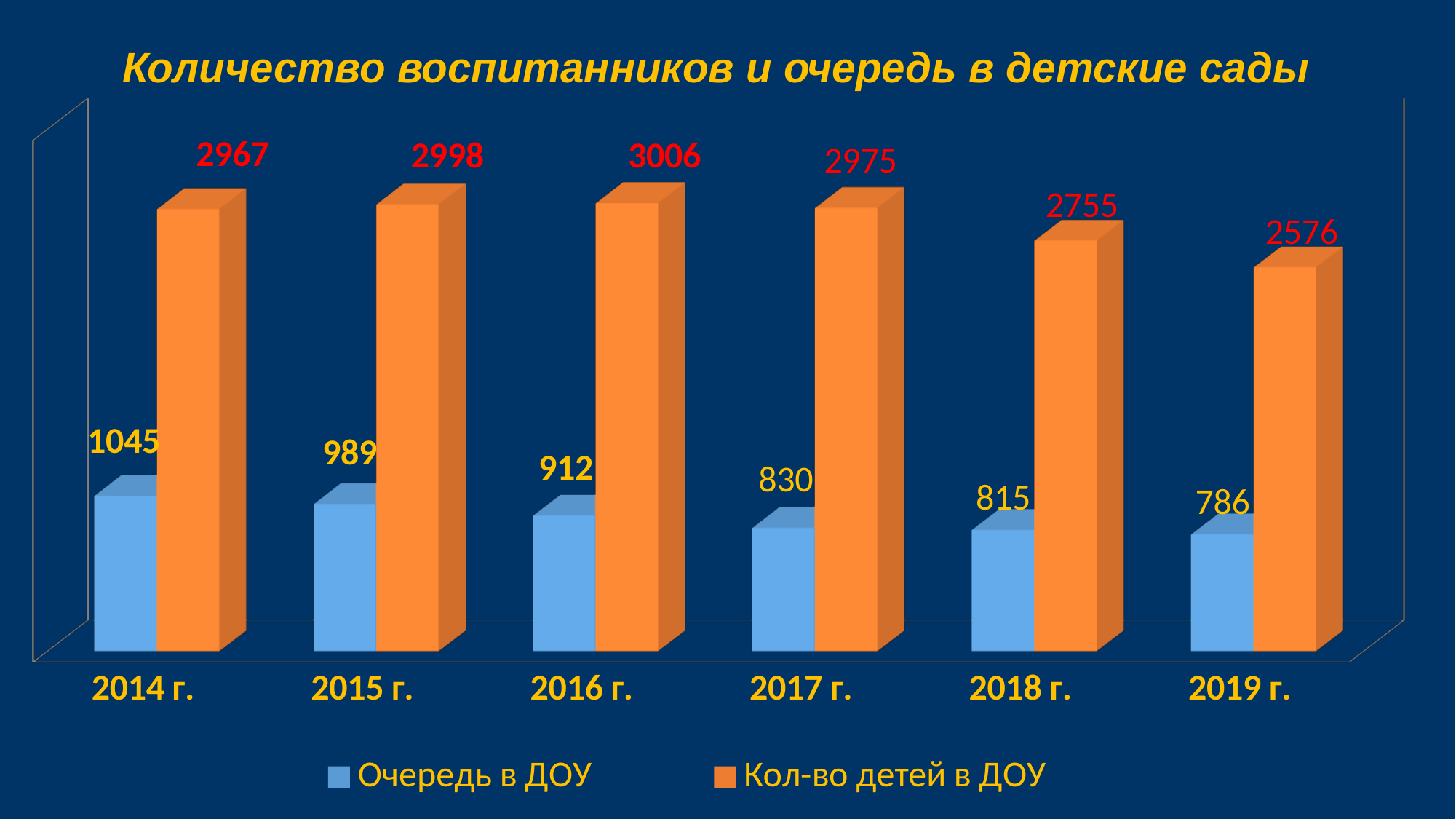
What is the difference between "Очередь в ДОУ" in 2014 г. and 2015 г.? 56 Which is larger: "Очередь в ДОУ" in 2017 г. or in 2018 г.? 2017 г. What is the value of "Кол-во детей в ДОУ" for 2018 г.? 2755 What is the value of "Очередь в ДОУ" for 2019 г.? 786 What is the value of "Очередь в ДОУ" for 2014 г.? 1045 How many years are shown on the x axis? 6 What is the difference between "Кол-во детей в ДОУ" in 2014 г. and 2019 г.? 391 What kind of chart is shown on the slide? Bar chart How many series does the legend list? 2 In which year is "Очередь в ДОУ" lowest? 2019 г. In which year is "Кол-во детей в ДОУ" highest? 2016 г. What is the value of "Кол-во детей в ДОУ" for 2016 г.? 3006